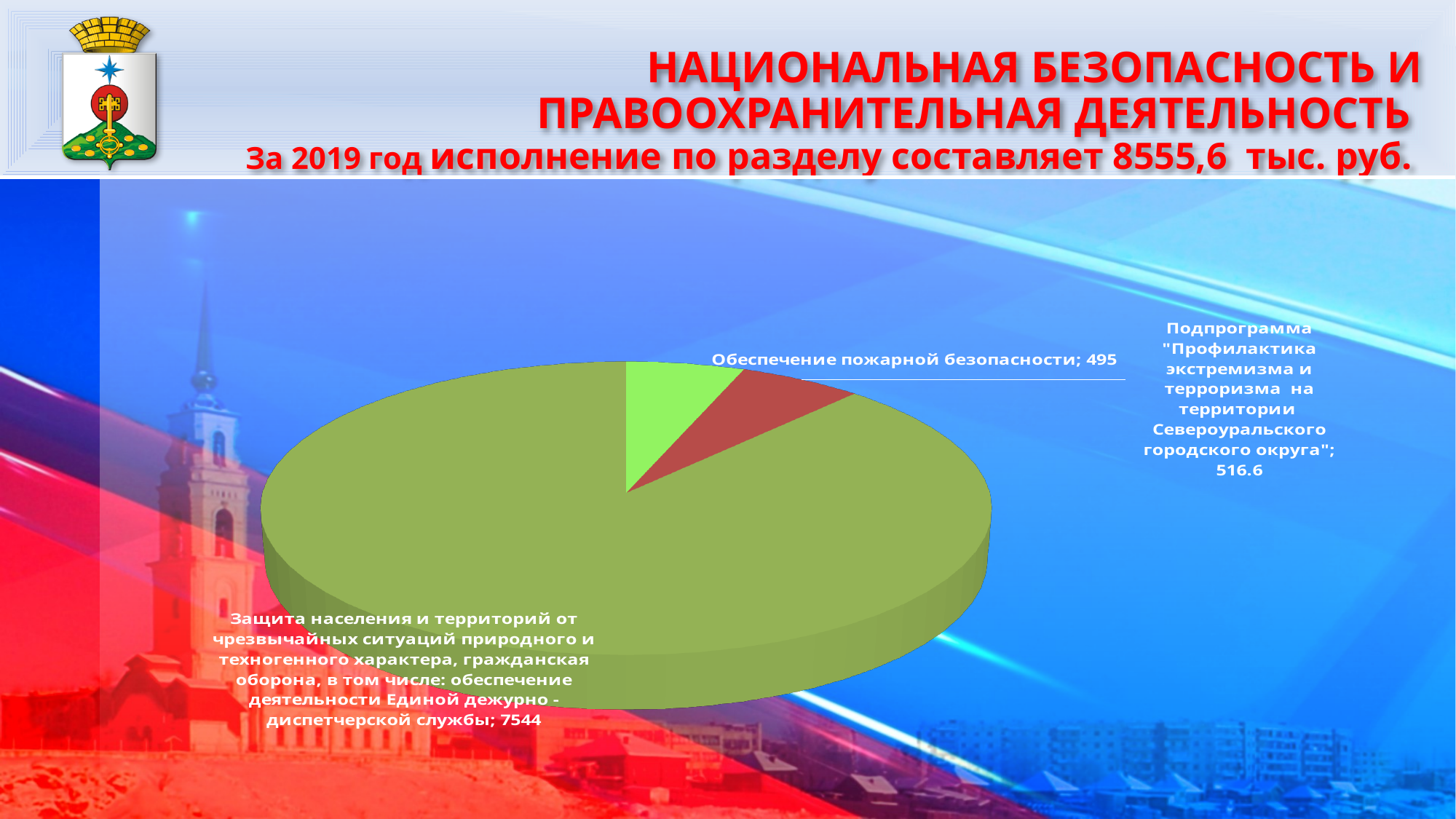
What type of chart is shown on the slide? Pie chart How many slices does the pie chart have? 3 Which category has the largest slice of the pie? Защита населения и территорий от чрезвычайных ситуаций природного и техногенного характера, гражданская оборона, в том числе: обеспечение деятельности Единой дежурно-диспетчерской службы What is the value for the subprogram "Профилактика экстремизма и терроризма на территории Североуральского городского округа"? 516.6 What is the difference between the value for the subprogram "Профилактика экстремизма и терроризма" and the value for "Обеспечение пожарной безопасности"? 21.6 What is the difference between the value for "Защита населения и территорий от чрезвычайных ситуаций..." and the value for "Обеспечение пожарной безопасности"? 7049 Which category has the smallest slice of the pie? Обеспечение пожарной безопасности What colour is the slice for "Обеспечение пожарной безопасности"? Green What is the value for "Защита населения и территорий от чрезвычайных ситуаций природного и техногенного характера, гражданская оборона, в том числе: обеспечение деятельности Единой дежурно-диспетчерской службы"? 7544 What is the total of all three slices of the pie chart? 8555.6 Which is larger: the value for "Обеспечение пожарной безопасности" or the value for the subprogram "Профилактика экстремизма и терроризма"? Подпрограмма "Профилактика экстремизма и терроризма" What is the value for "Обеспечение пожарной безопасности"? 495